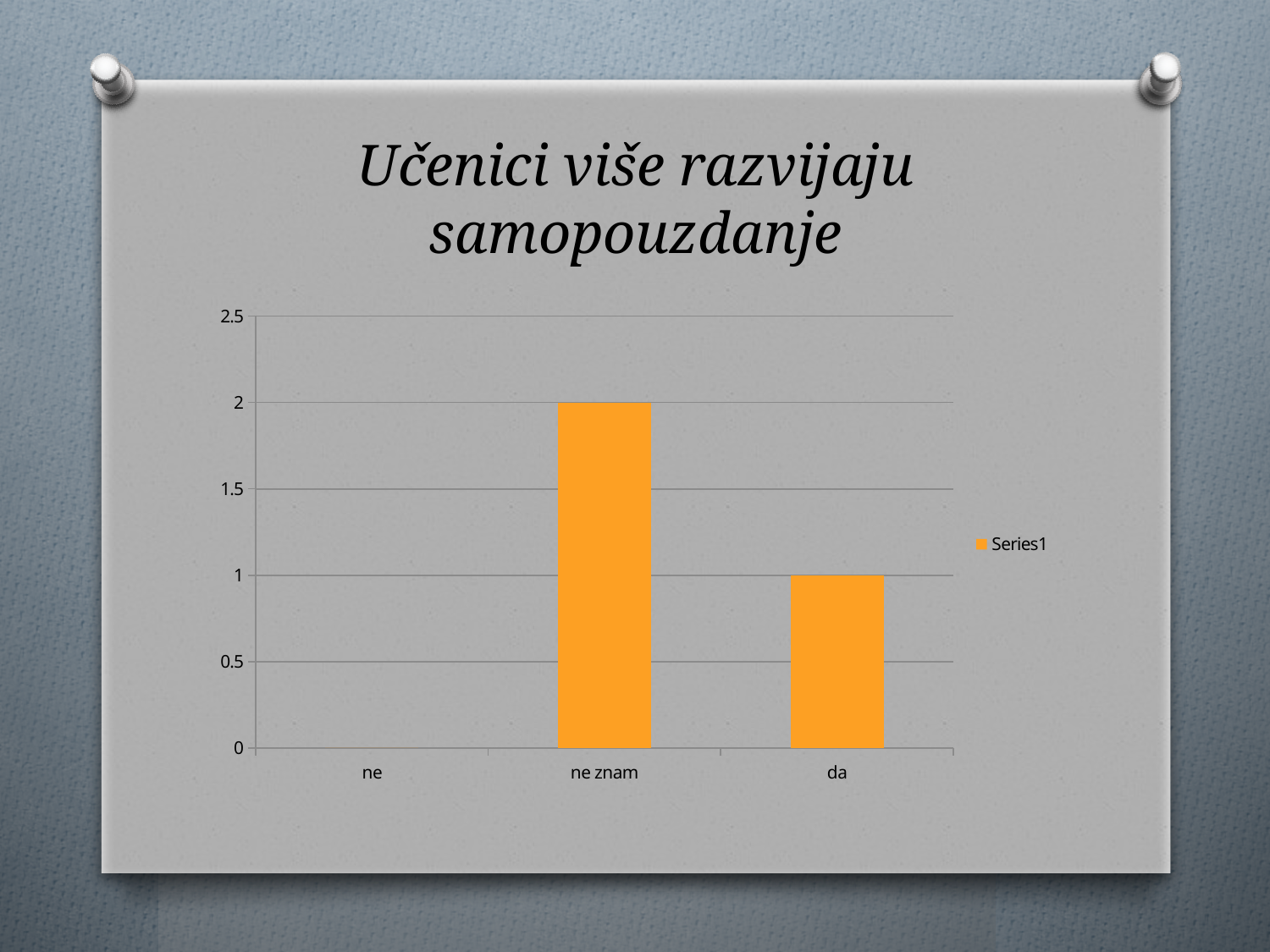
Which category has the lowest value? ne What is the title of the chart? Učenici više razvijaju samopouzdanje Is the value for "ne znam" greater or less than 1.5? greater What is the value for "da"? 1 What is the difference between the values for "ne znam" and "da"? 1 What is the value for "ne znam"? 2 What is the value for "ne"? 0 Which is larger, the value for "ne znam" or the value for "da"? ne znam What kind of chart is shown on the slide? bar chart How many categories are shown on the x axis? 3 Which category has the highest value? ne znam How many series does the legend list? 1